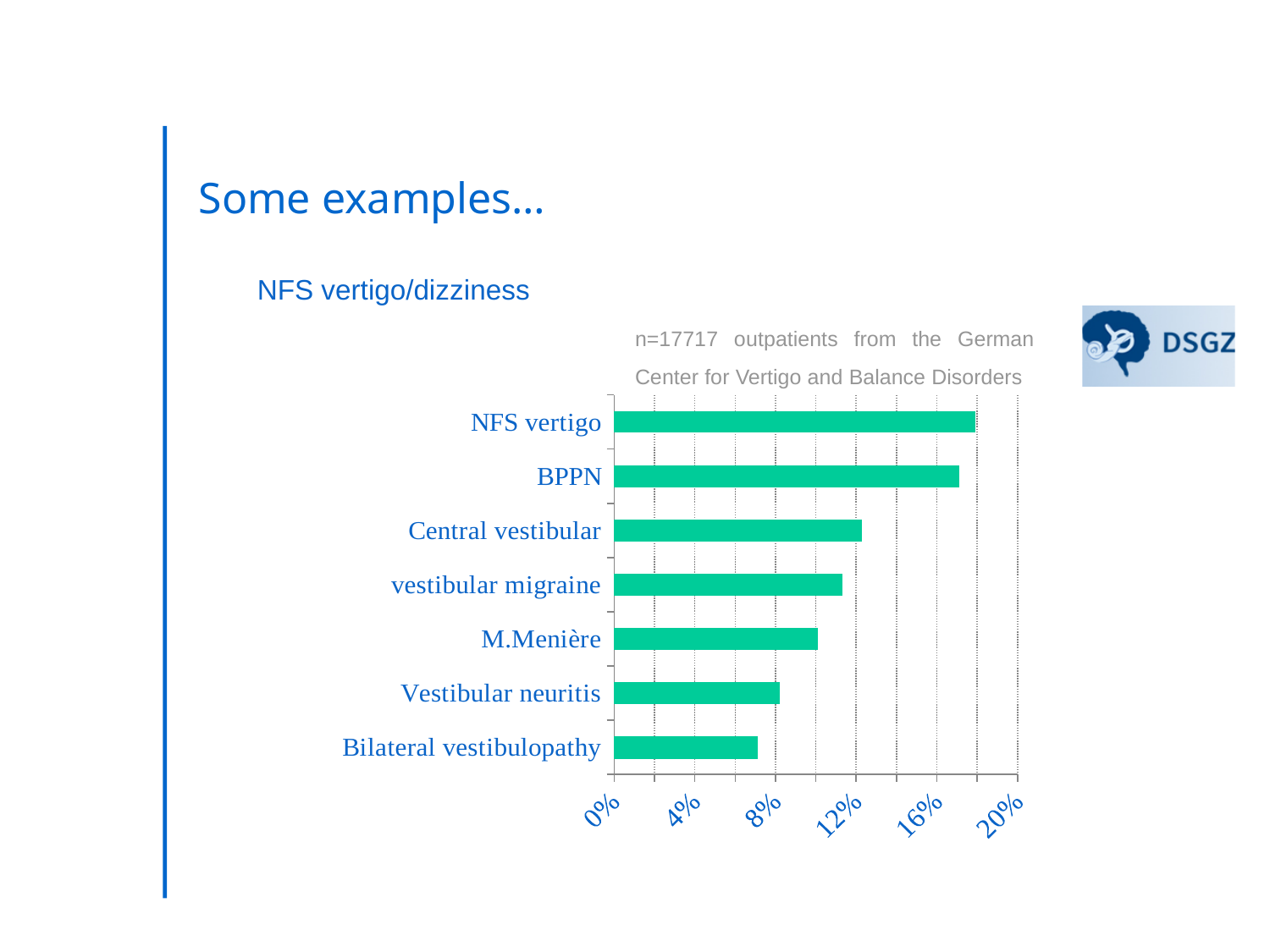
Is the value for vestibular migraine greater or less than 12%? less How many outpatients does the chart's note say the data is based on? n=17717 Which category has the highest value in the chart? NFS vertigo Is the value for M.Menière greater or less than 12%? less Which has a larger value, Vestibular neuritis or BPPN? BPPN Is the value for Bilateral vestibulopathy greater or less than 8%? less How many categories are plotted in the chart? 7 What kind of chart is shown on the slide? bar chart Which has a larger value, Central vestibular or M.Menière? Central vestibular Which category has the lowest value in the chart? Bilateral vestibulopathy